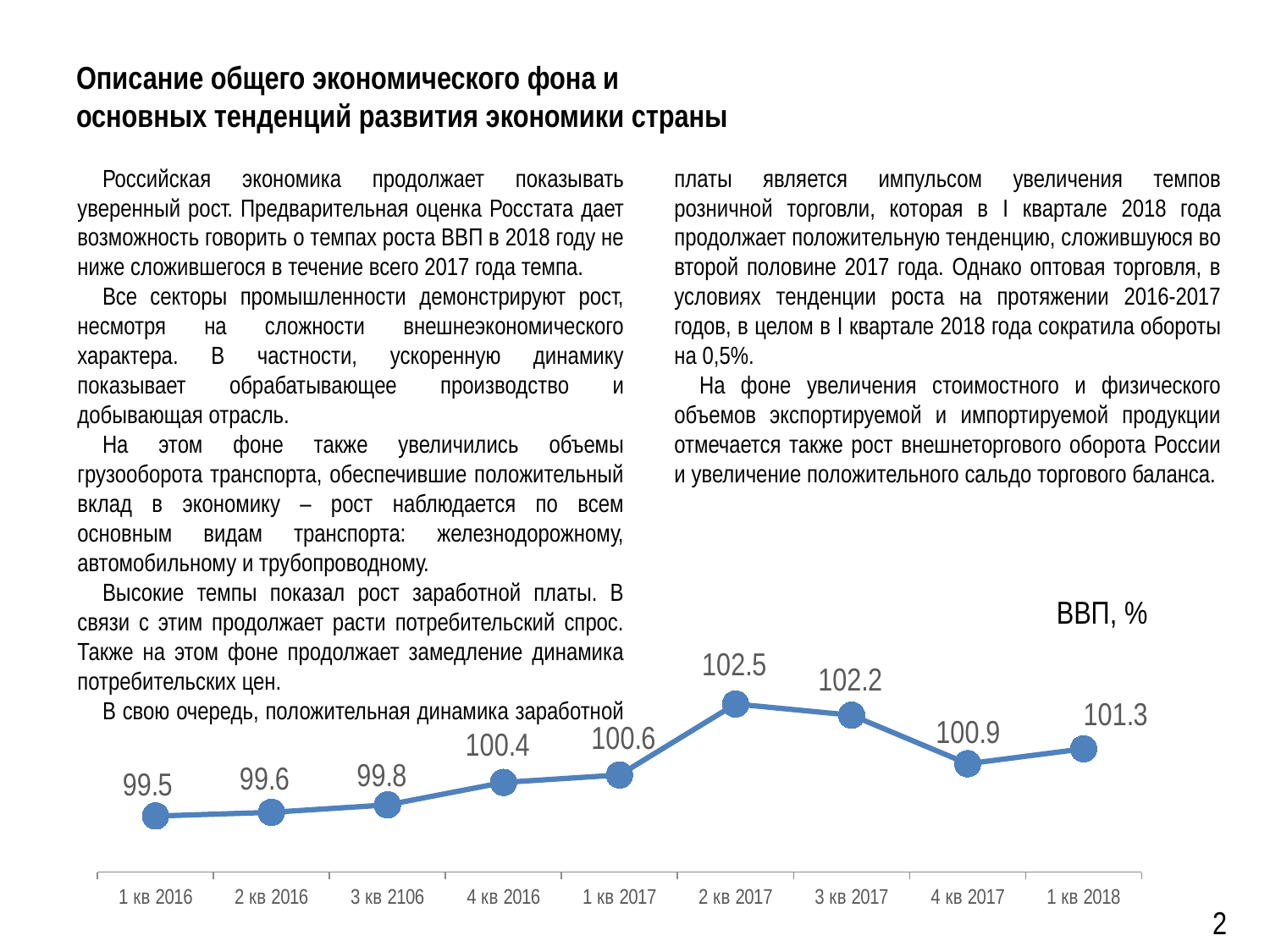
How many data points are plotted on the ВВП, % chart? 9 Which quarter has the lowest value on the ВВП, % chart? 1 кв 2016 What is the value for 1 кв 2018 on the ВВП, % chart? 101.3 Which quarter has the highest value on the ВВП, % chart? 2 кв 2017 What is the value for 4 кв 2016 on the ВВП, % chart? 100.4 What is the value for 2 кв 2017 on the ВВП, % chart? 102.5 What is the title of the chart on the slide? ВВП, % Which is larger on the ВВП, % chart: the value for 3 кв 2017 or the value for 4 кв 2017? 3 кв 2017 What is the difference between the values for 2 кв 2017 and 1 кв 2017 on the ВВП, % chart? 1.9 Do the values on the ВВП, % chart rise or fall from 1 кв 2016 to 2 кв 2017? rise What is the difference between the values for 1 кв 2018 and 4 кв 2017 on the ВВП, % chart? 0.4 What kind of chart is the ВВП, % chart? line chart